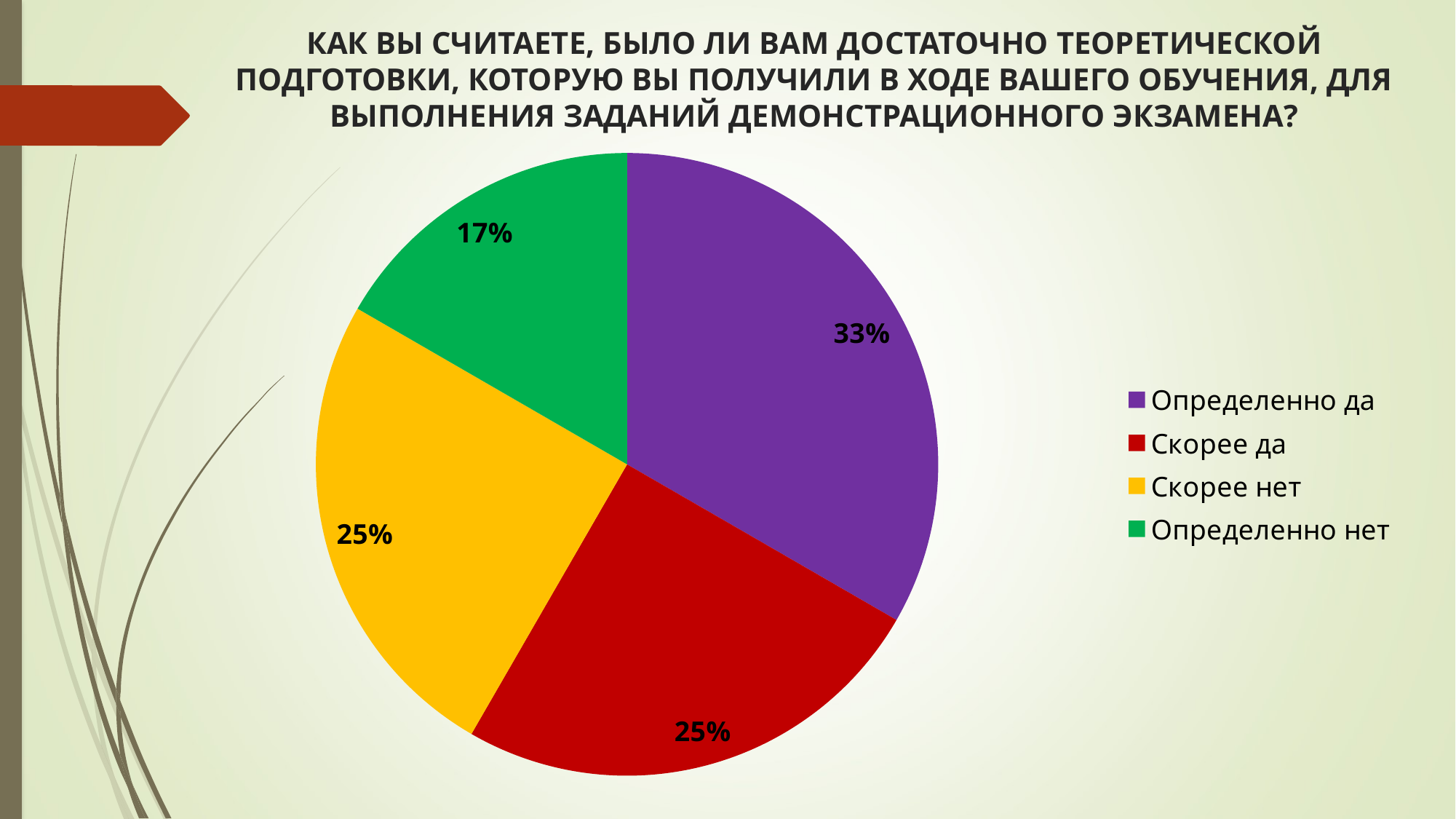
How many categories does the pie chart have? 4 Which category has the smallest slice of the pie? Определенно нет What colour is the slice for "Скорее нет"? yellow What is the difference between the values for "Определенно да" and "Определенно нет"? 16% What kind of chart is shown on the slide? pie chart What is the value shown for "Скорее нет"? 25% What is the value shown for "Определенно нет"? 17% Which category has the largest slice of the pie? Определенно да What share of the pie does "Определенно да" take? 33% What is the combined share of "Скорее да" and "Скорее нет"? 50% Which is larger, the slice for "Определенно да" or the slice for "Скорее да"? Определенно да What is the value shown for "Скорее да"? 25%